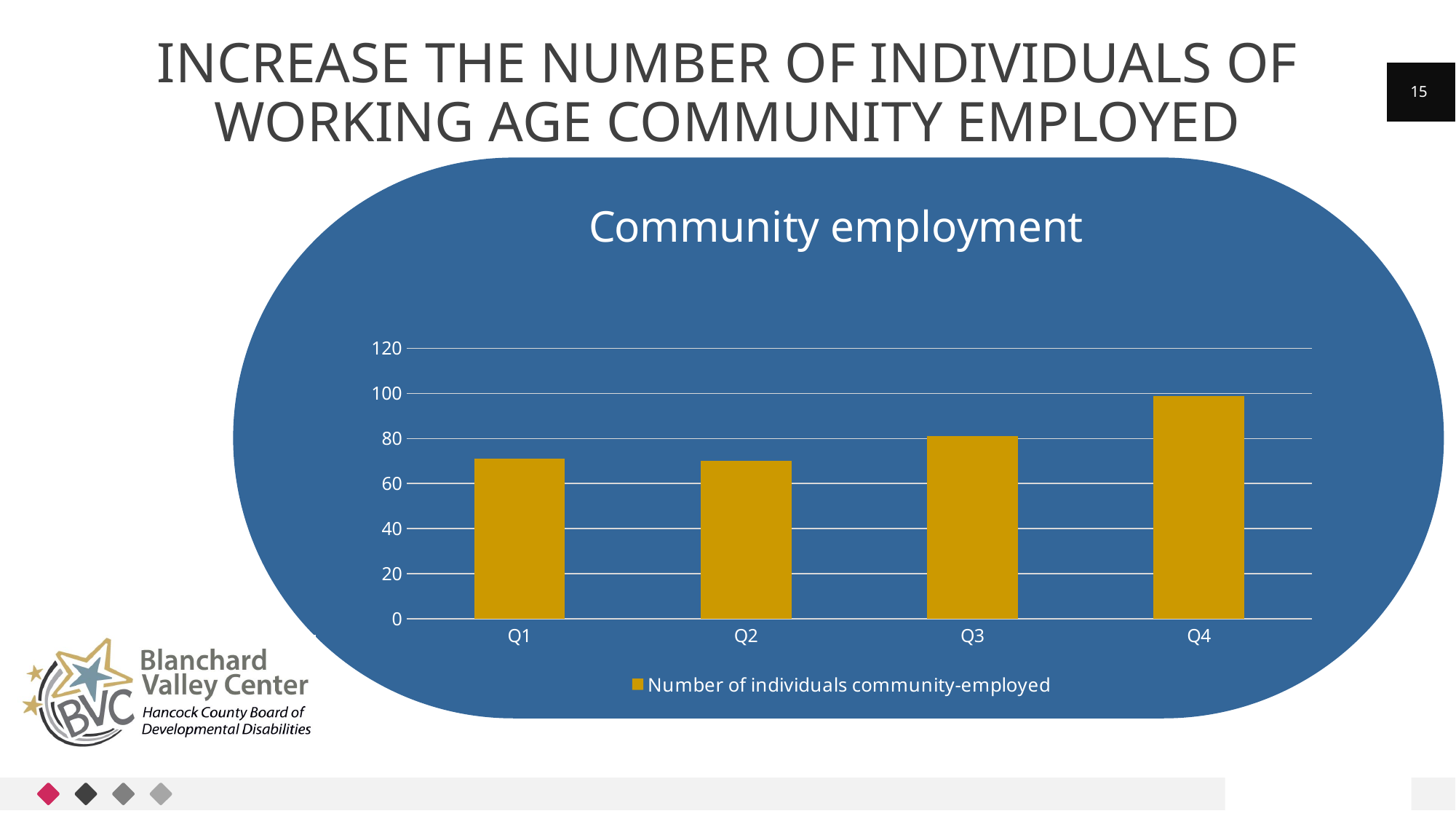
Is the value for Q3 greater or less than 100? less Is the value for Q4 higher or lower than the value for Q1? higher Is the value for Q4 greater or less than 80? greater What is the title of the chart? Community employment Which quarter has the highest number of individuals community-employed? Q4 Is the value for Q1 greater or less than 80? less Which is larger, the value for Q3 or the value for Q2? Q3 How many series does the chart legend list? 1 How many categories are shown on the x axis of the chart? 4 What type of chart is shown on the slide? Bar chart What is the legend entry for the series in the chart? Number of individuals community-employed